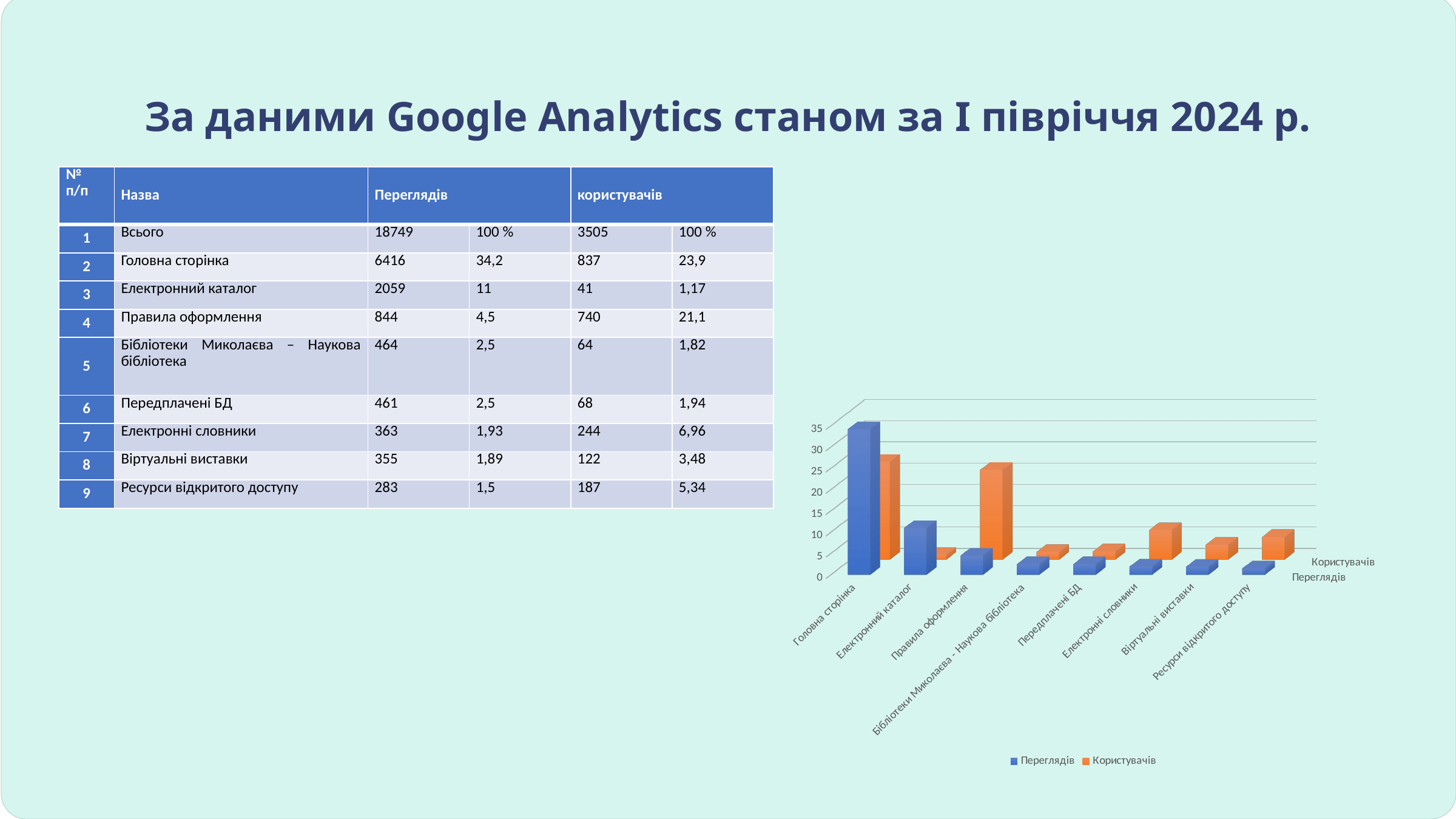
Which category has the highest Переглядів bar in the chart? Головна сторінка Is the Переглядів value for Головна сторінка in the chart greater or less than 30? greater Is the Користувачів value for Правила оформлення in the chart greater or less than 15? greater What kind of chart is shown on the right of the slide? bar chart How many categories are shown along the x axis of the chart? 8 How many series does the chart legend list? 2 For Правила оформлення, which series has the larger bar in the chart, Переглядів or Користувачів? Користувачів Do the Переглядів bars generally rise or fall from left to right along the x axis? fall Is the Переглядів value for Електронний каталог in the chart greater or less than 15? less For Електронний каталог, which series has the larger bar in the chart, Переглядів or Користувачів? Переглядів Which colour represents the Користувачів series in the chart? orange